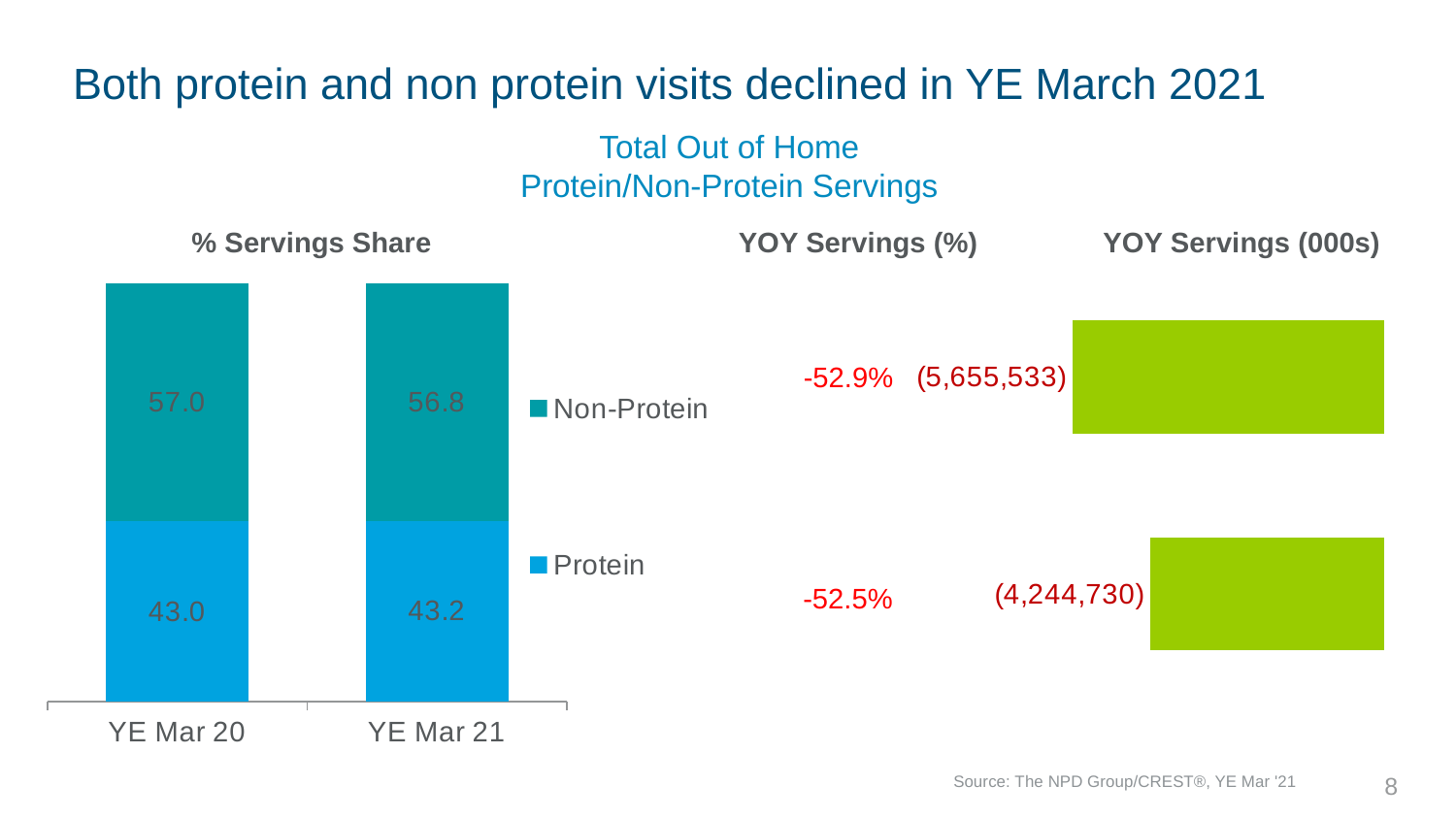
In the YOY Servings (000s) chart, what is the value for Protein? (4,244,730) In the % Servings Share chart, what is the difference between the Non-Protein and Protein values for YE Mar 20? 14.0 What kind of chart is the % Servings Share chart? Stacked bar chart How many categories are shown on the x axis of the % Servings Share chart? 2 In the % Servings Share chart, what is the total of the stacked bar for YE Mar 21? 100.0 In the YOY Servings (%) chart, what is the value for Non-Protein? -52.9% In the % Servings Share chart, what is the Protein value for YE Mar 20? 43.0 In the % Servings Share chart, what is the Protein value for YE Mar 21? 43.2 In the % Servings Share chart, what is the Non-Protein value for YE Mar 20? 57.0 In the % Servings Share chart, which series has the larger share in YE Mar 21, Non-Protein or Protein? Non-Protein How many series does the legend of the % Servings Share chart list? 2 In the % Servings Share chart, what is the Non-Protein value for YE Mar 21? 56.8